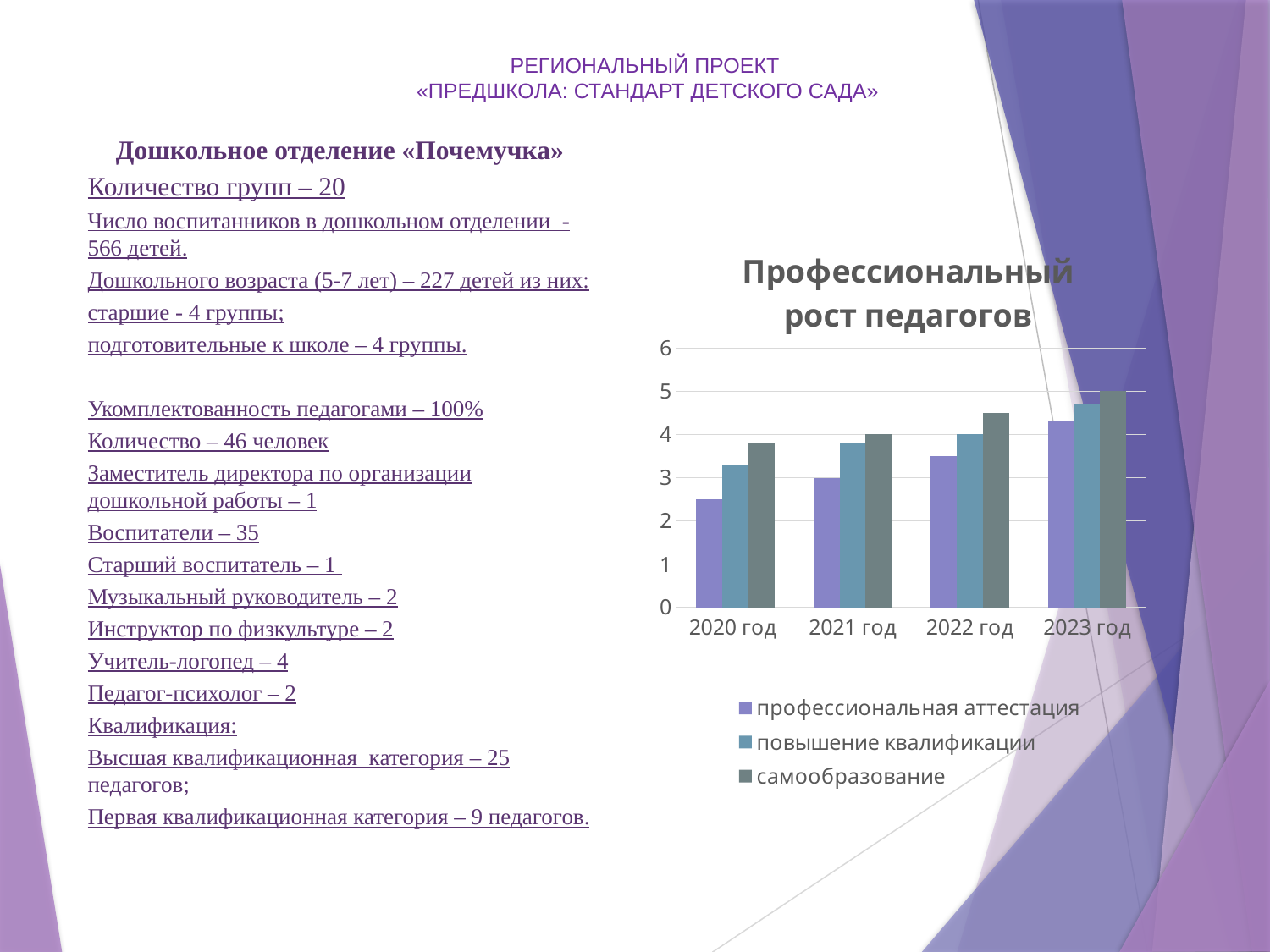
In the «Профессиональный рост педагогов» chart, which is larger for 2020 год: «самообразование» or «профессиональная аттестация»? самообразование What is the title of the chart on the slide? Профессиональный рост педагогов How many series does the legend of the «Профессиональный рост педагогов» chart list? 3 In the «Профессиональный рост педагогов» chart, is the value for «повышение квалификации» in 2023 год greater or less than 4? greater Which year has the highest bar for «самообразование» in the «Профессиональный рост педагогов» chart? 2023 год Which year has the lowest bar for «профессиональная аттестация» in the «Профессиональный рост педагогов» chart? 2020 год In the «Профессиональный рост педагогов» chart, which series is shown in the darkest (grey-green) colour? самообразование How many year categories are shown on the x axis of the «Профессиональный рост педагогов» chart? 4 In the «Профессиональный рост педагогов» chart, is the value for «самообразование» in 2022 год greater or less than 4? greater In the «Профессиональный рост педагогов» chart, is the value for «профессиональная аттестация» in 2020 год greater or less than 3? less What kind of chart is shown under the title «Профессиональный рост педагогов»? bar chart In the «Профессиональный рост педагогов» chart, do the values for «повышение квалификации» rise or fall from 2020 год to 2023 год? rise